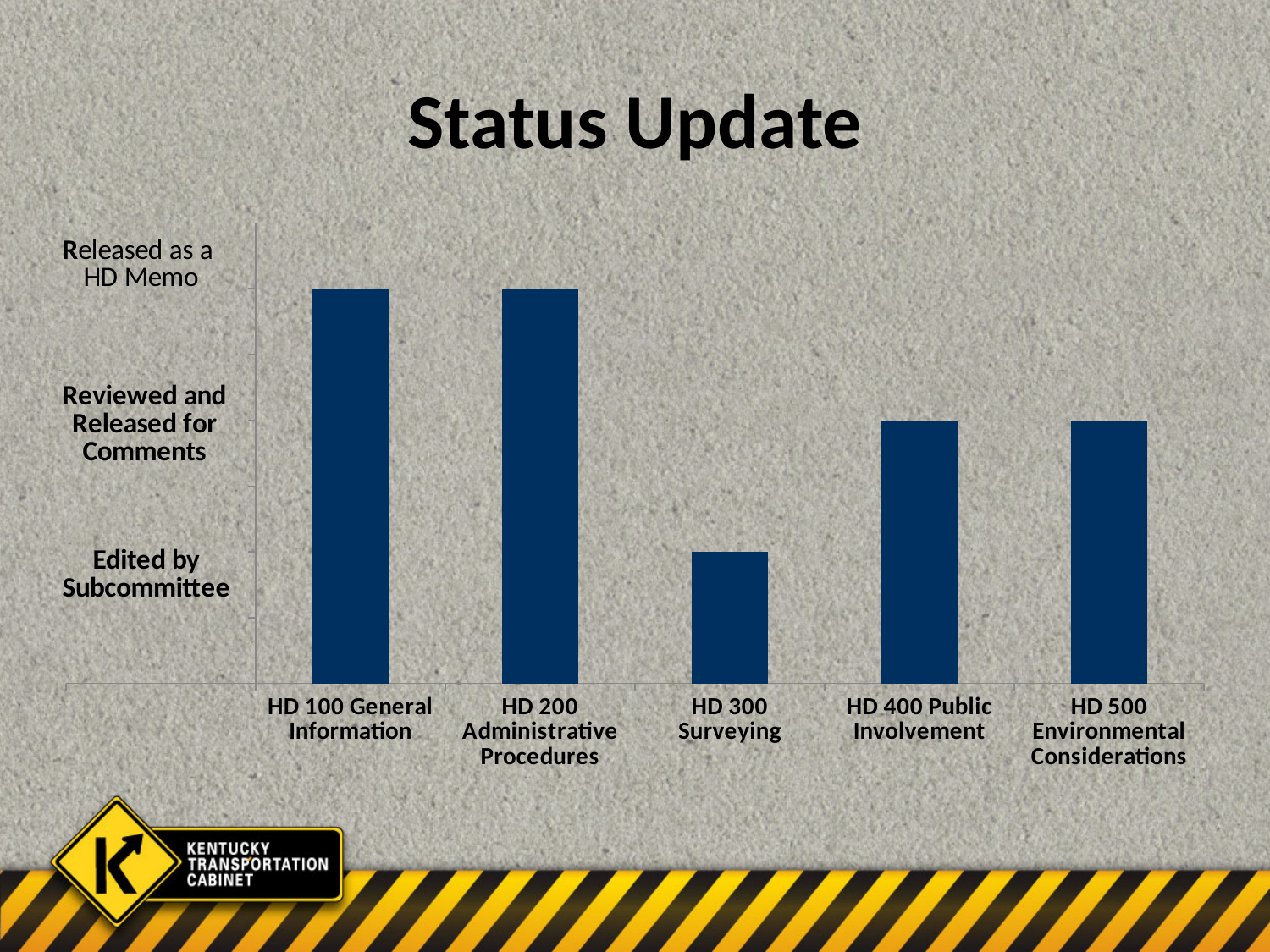
Which is higher, the bar for HD 200 Administrative Procedures or the bar for HD 400 Public Involvement? HD 200 Administrative Procedures What is the title of the chart? Status Update How many categories have bars reaching the 'Released as a HD Memo' level? 2 What status level does the bar for HD 200 Administrative Procedures reach? Released as a HD Memo What kind of chart is shown on the slide? Bar chart What status level does the bar for HD 300 Surveying reach? Edited by Subcommittee How many categories (bars) are shown in the chart? 5 What status level does the bar for HD 500 Environmental Considerations reach? Reviewed and Released for Comments What status level does the bar for HD 400 Public Involvement reach? Reviewed and Released for Comments What status level does the bar for HD 100 General Information reach? Released as a HD Memo Which category has the lowest bar in the chart? HD 300 Surveying Which is higher, the bar for HD 300 Surveying or the bar for HD 500 Environmental Considerations? HD 500 Environmental Considerations